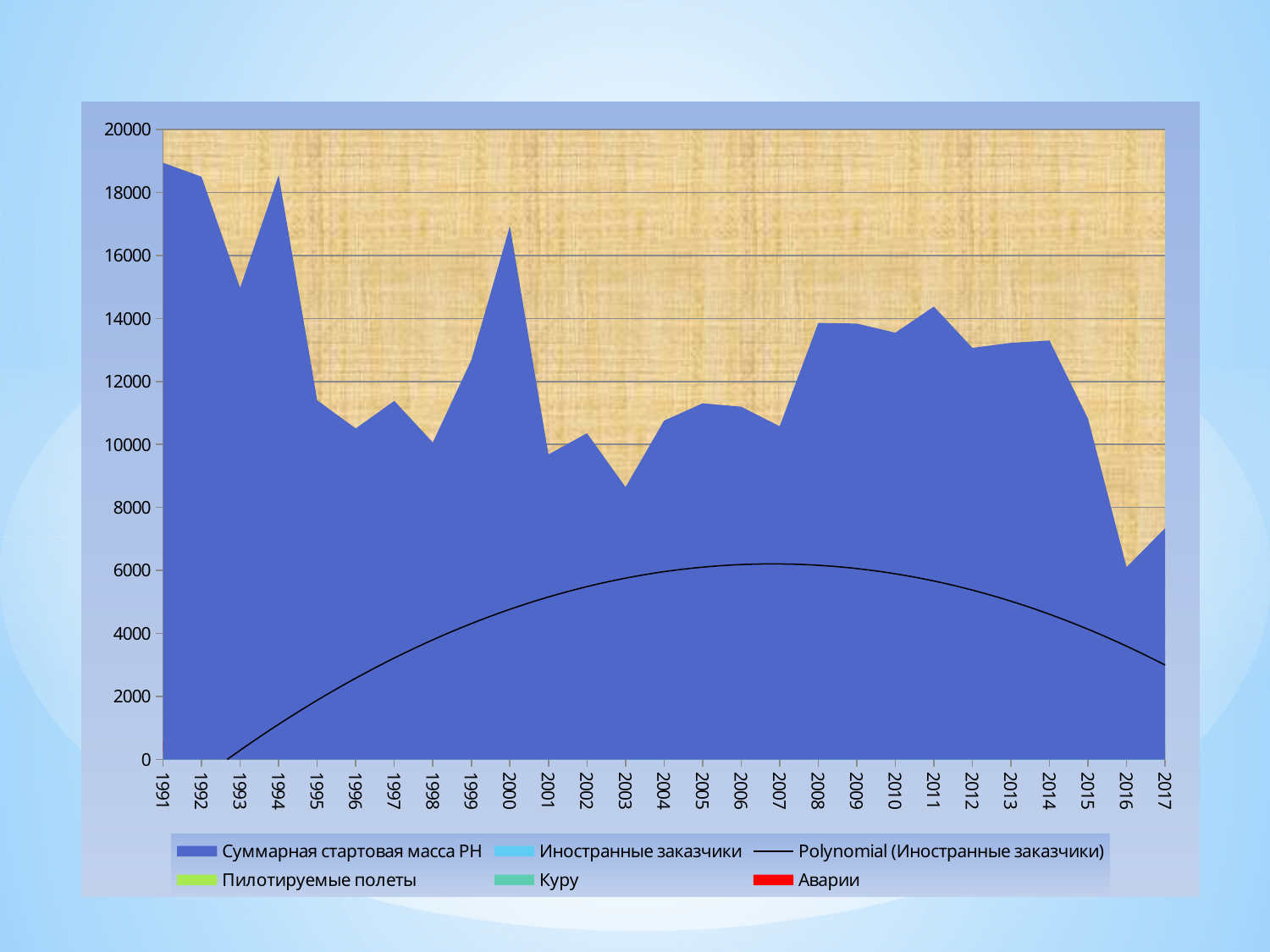
Which year has the lowest value for Суммарная стартовая масса РН? 2016 What kind of chart is shown on the slide? area chart How many series does the chart's legend list? 6 Which is larger, the value for Суммарная стартовая масса РН in 2000 or in 2003? 2000 Is the value for Суммарная стартовая масса РН in 2003 greater or less than 10000? less What is the first year shown on the x axis of the chart? 1991 What colour is used for the legend entry Аварии? red Is the value for Суммарная стартовая масса РН in 2016 greater or less than 8000? less Is the value for Суммарная стартовая масса РН in 1991 greater or less than 18000? greater Does the value for Суммарная стартовая масса РН rise or fall from 2014 to 2016? fall How many years are shown along the x axis of the chart? 27